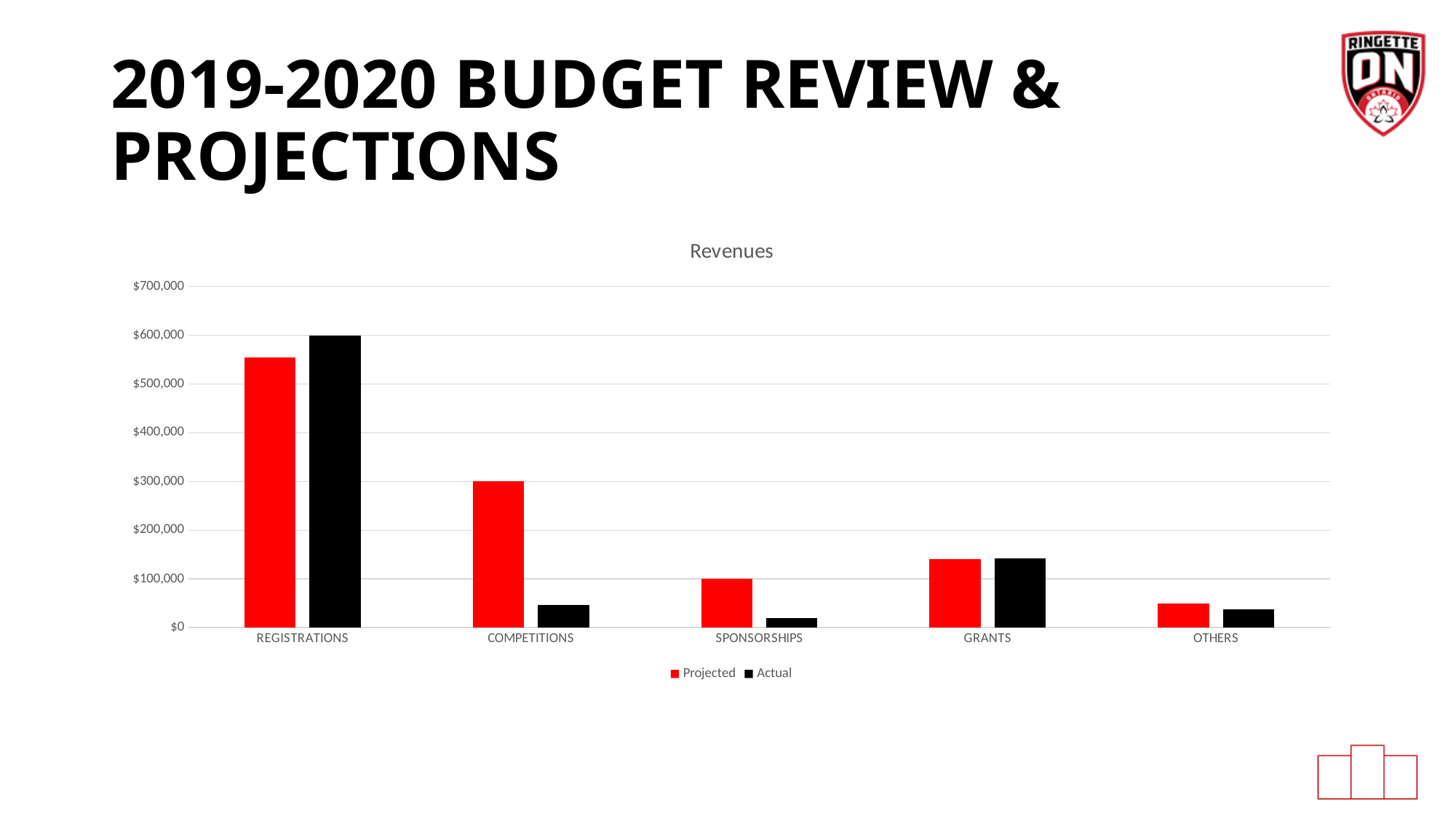
How many series does the legend list? 2 Which category has the lowest Actual revenue? Sponsorships Is the Projected value for Registrations greater or less than $500,000? greater How many categories are shown on the x axis? 5 Is the Actual value for Competitions greater or less than $100,000? less What kind of chart is shown on the slide? Bar chart Is the Projected value for Grants greater or less than $100,000? greater What is the title of the chart? Revenues For Competitions, which is larger: the Projected or the Actual value? Projected For Registrations, which is larger: the Projected or the Actual value? Actual Which colour represents the Actual series in the legend? Black Which category has the highest Projected revenue? Registrations